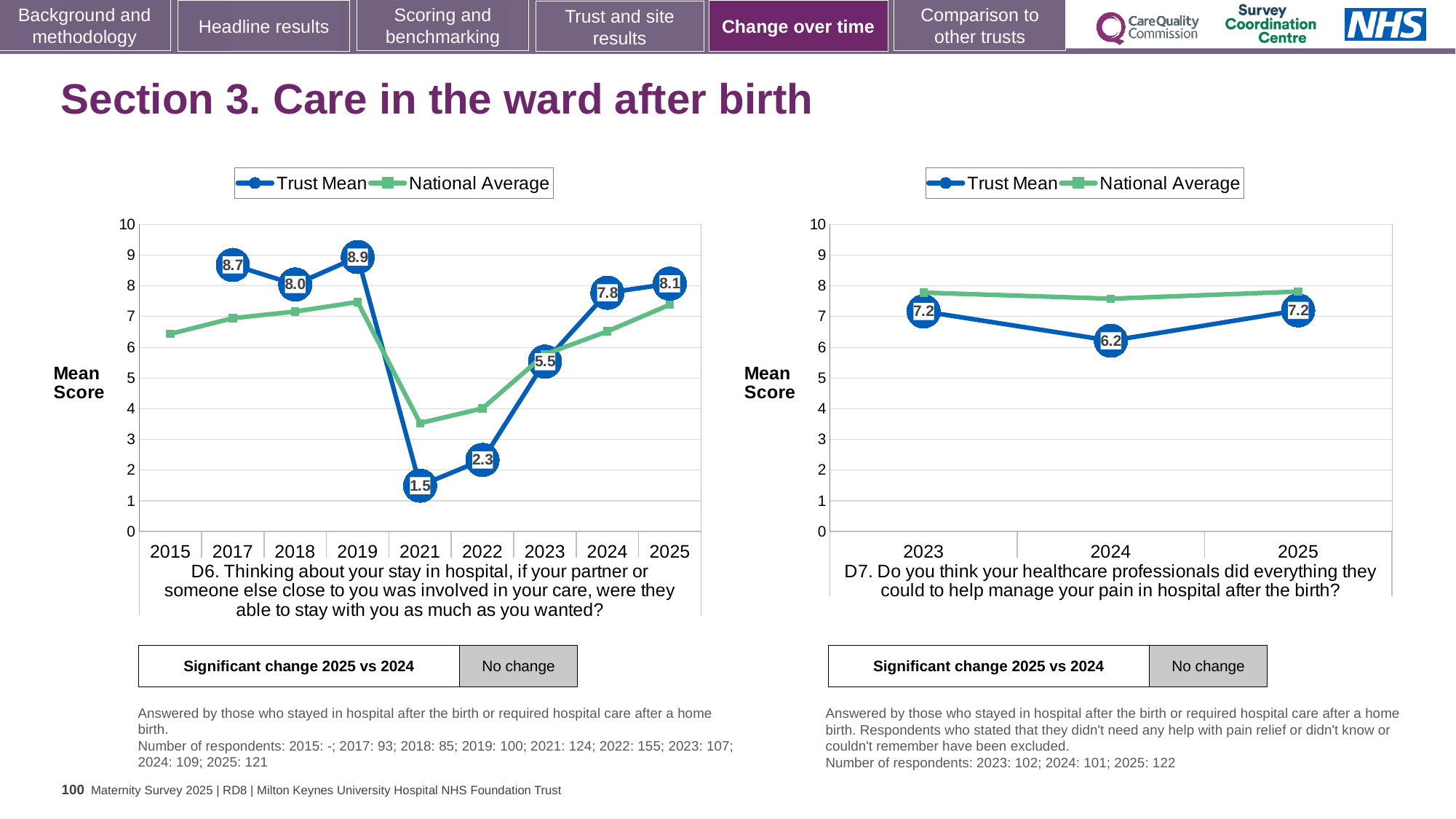
In the D7 chart on the right, which year has the lowest Trust Mean? 2024 In the D6 chart on the left, what is the Trust Mean for 2025? 8.1 What type of chart is the D7 chart on the right? Line chart In the D6 chart on the left, what is the difference between the Trust Mean for 2025 and 2024? 0.3 In the D6 chart on the left, is the National Average for 2021 greater or less than 4? less In the D6 chart on the left, how many years are shown on the x axis? 9 In the D6 chart on the left, what is the Trust Mean for 2021? 1.5 In the D6 chart on the left, which year has the highest Trust Mean? 2019 In the D7 chart on the right, how many series does the legend list? 2 In the D6 chart on the left, which year has the lowest Trust Mean? 2021 In the D7 chart on the right, what is the Trust Mean for 2024? 6.2 In the D7 chart on the right, is the National Average for 2023 greater or less than 7? greater